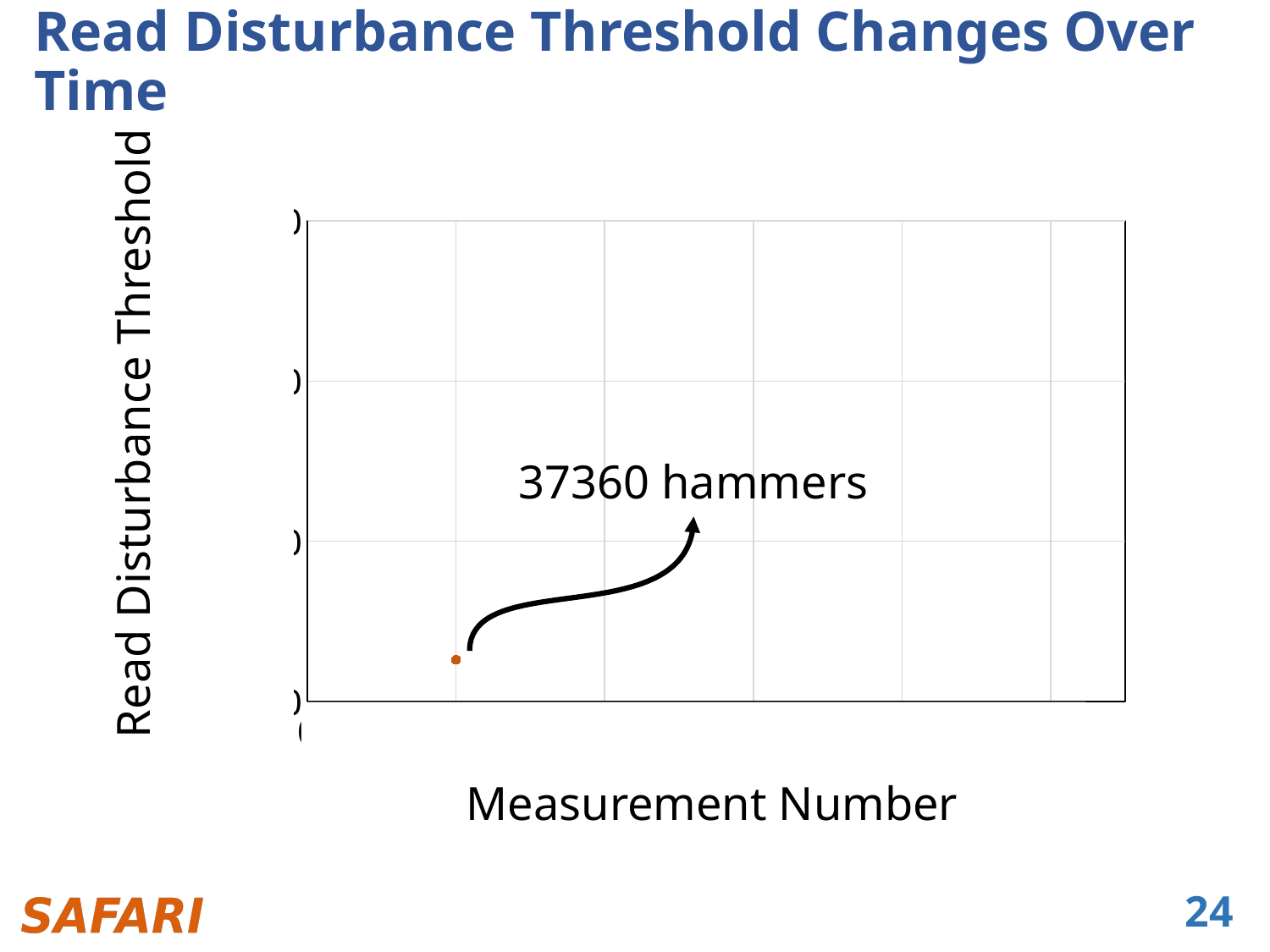
What value is annotated for the plotted data point on the chart? 37360 hammers What is the label of the x axis of the chart? Measurement Number What is the label of the y axis of the chart? Read Disturbance Threshold What kind of chart is shown on the slide? scatter chart How many data points are plotted on the chart? 1